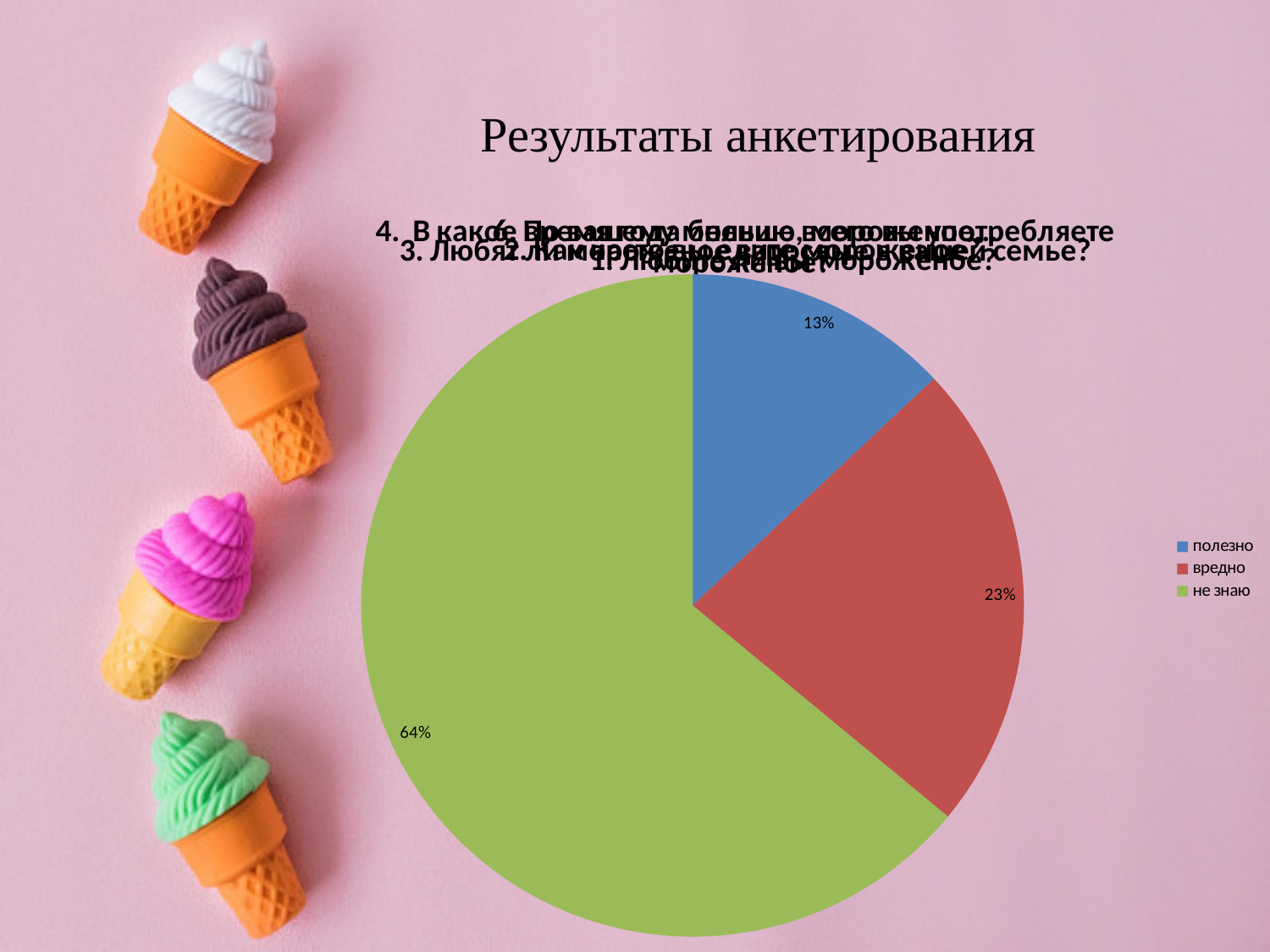
Which slice is larger, "вредно" or "полезно"? вредно What kind of chart is shown on the slide? pie chart What share of the pie does the "не знаю" slice represent? 64% What is the difference in percentage points between the "вредно" slice and the "полезно" slice? 10 What share of the pie does the "полезно" slice represent? 13% What colour is the "не знаю" slice in the pie chart? green What share of the pie does the "вредно" slice represent? 23% What is the difference in percentage points between the "не знаю" slice and the "вредно" slice? 41 Which category has the largest slice of the pie? не знаю How many entries does the legend list? 3 How many slices does the pie chart have? 3 Which category has the smallest slice of the pie? полезно